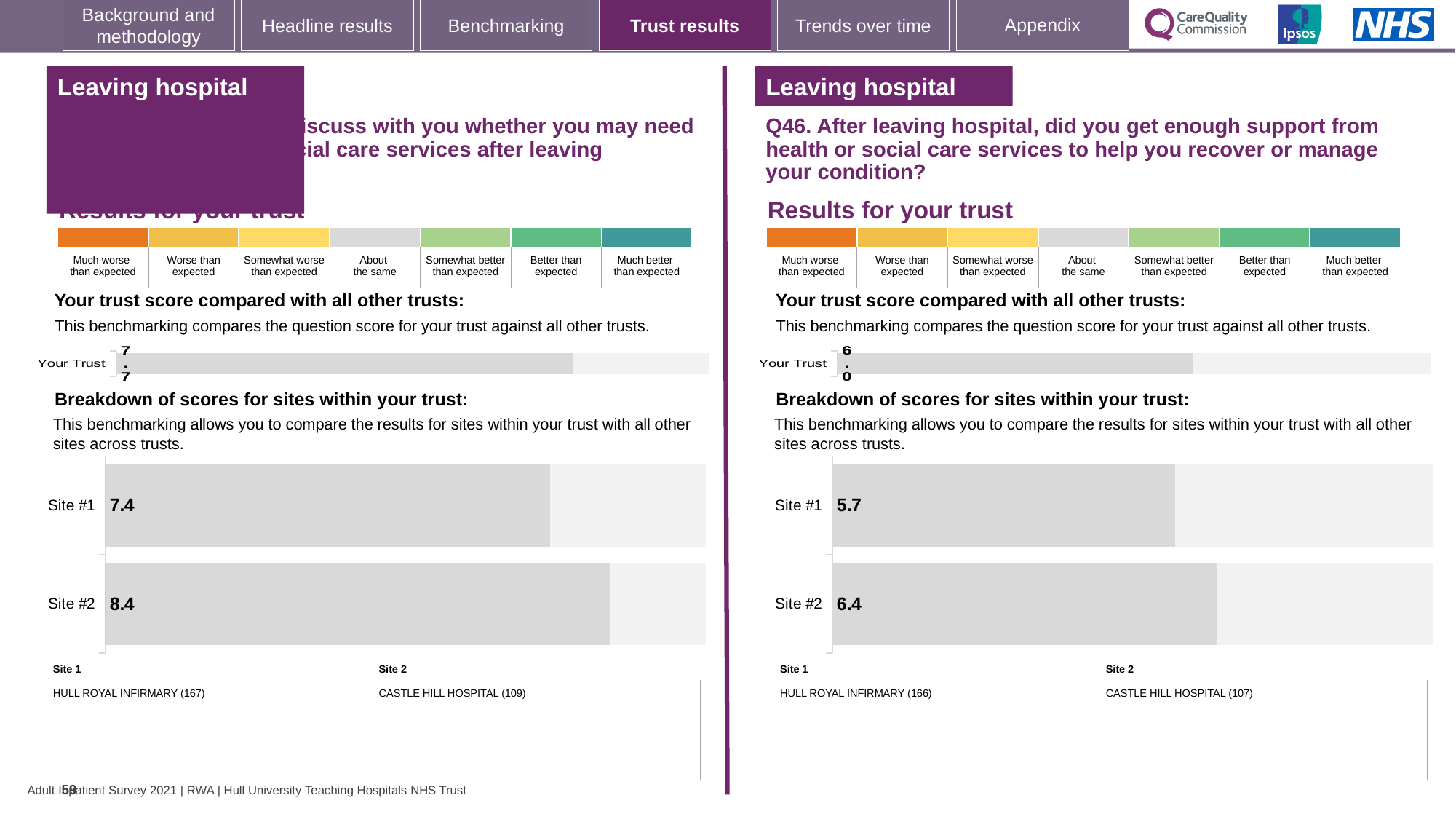
How many sites are shown on the Q46 site breakdown chart? 2 On the left-hand site breakdown chart, what is the score for Site #1? 7.4 On the left-hand site breakdown chart, what is the score for Site #2? 8.4 On the Q46 site breakdown chart, what is the difference between the Site #2 and Site #1 scores? 0.7 On the Q46 site breakdown chart (right-hand side), what is the score for Site #2? 6.4 What type of chart is used for the site breakdown on the right-hand side of the slide? Bar chart On the left-hand 'Your trust score compared with all other trusts' chart, what is the score for Your Trust? 7.7 On the Q46 'Your trust score compared with all other trusts' chart, what is the score for Your Trust? 6.0 On the left-hand site breakdown chart, which site has the higher score? Site #2 On the left-hand site breakdown chart, what is the difference between the Site #2 and Site #1 scores? 1.0 On the Q46 site breakdown chart (right-hand side), what is the score for Site #1? 5.7 On the Q46 site breakdown chart, which site has the lower score? Site #1